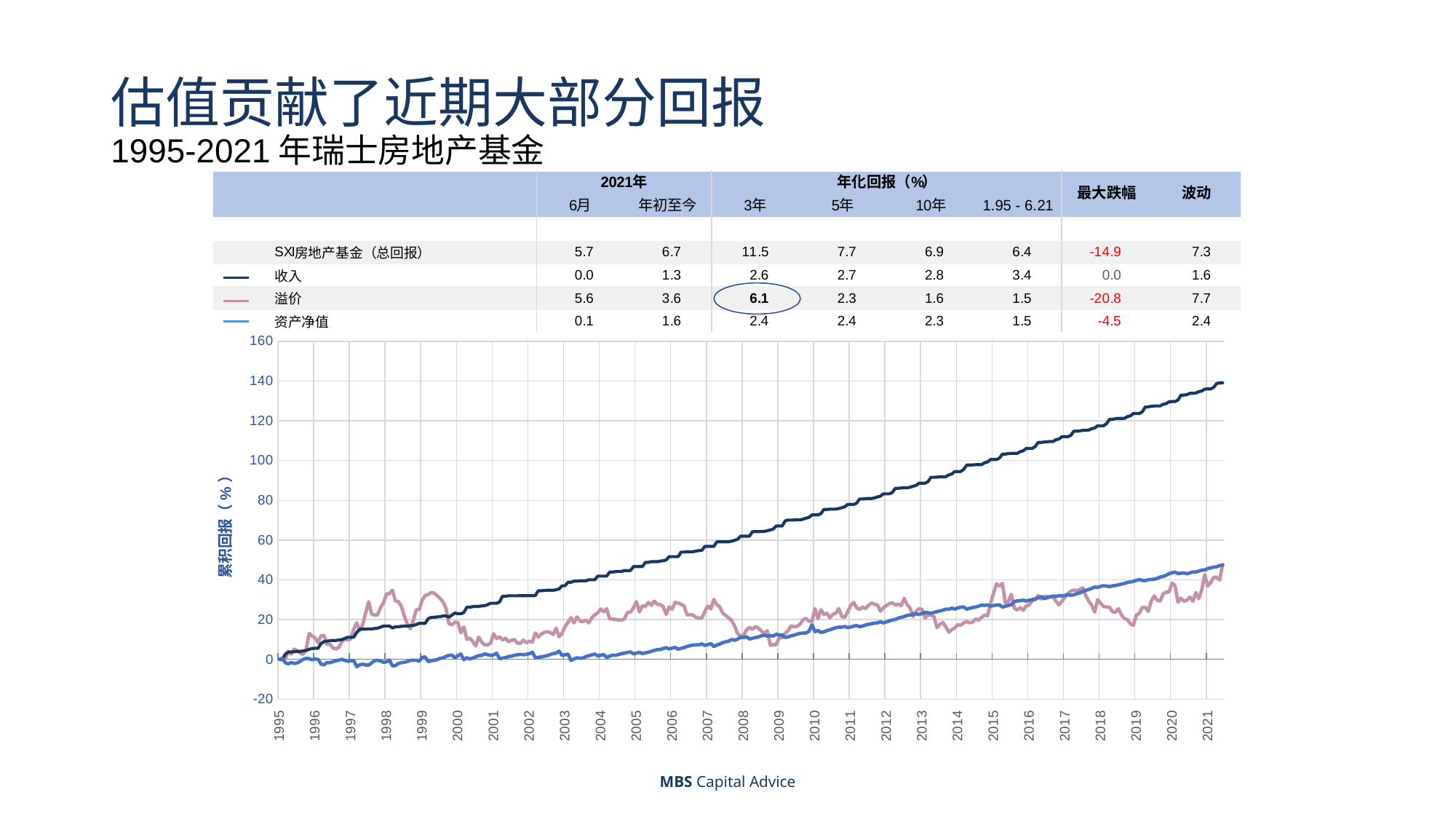
Is the value of the 收入 line in 2010 greater or less than 60? greater Is the value of the 收入 line in 2021 greater or less than 120? greater What kind of chart is shown on the slide? line chart How many series are plotted in the chart? 3 Does the 收入 line rise or fall from 1995 to 2021? rises At the end of 2021, which is larger: the 收入 line or the 资产净值 line? 收入 How many year labels are shown on the x axis? 27 Is the value of the 资产净值 line in 2021 greater or less than 40? greater Which series has the lowest cumulative return in 2005? 资产净值 Which series has the highest cumulative return at the end of 2021? 收入 What is the label of the y axis? 累积回报（%）